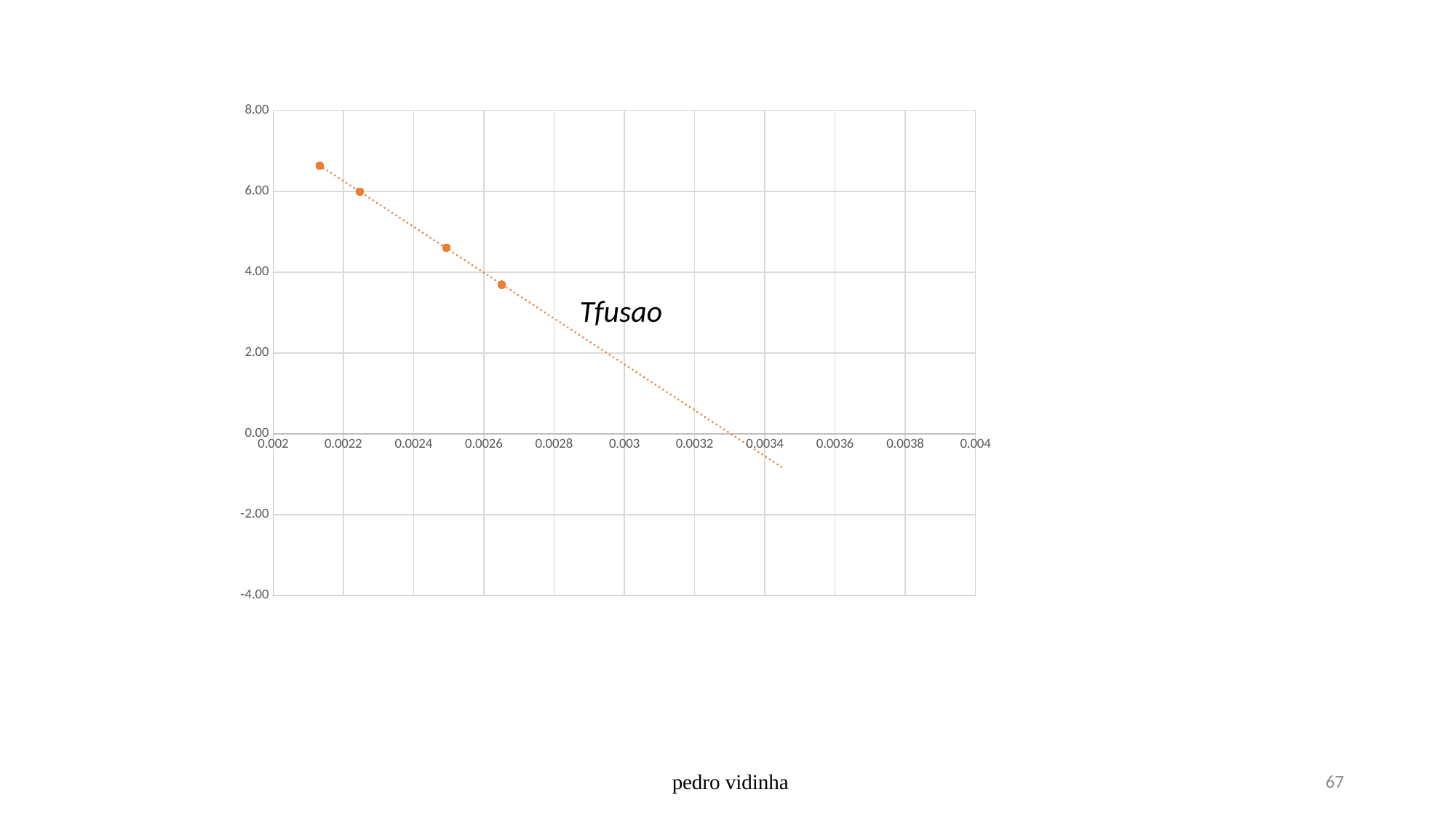
Is the value of the leftmost data point greater or less than 6.00? greater What kind of chart is shown on the slide? scatter chart What is the lowest value shown on the vertical axis? -4.00 How many data points are plotted on the chart? 4 What text label is shown next to the trendline on the chart? Tfusao Is the value of the third data point from the left greater or less than 4.00? greater What is the highest value shown on the vertical axis? 8.00 Which data point has the highest value, the leftmost or the rightmost? the leftmost Do the plotted values rise or fall as the x value increases? fall Is the value of the rightmost data point greater or less than 4.00? less